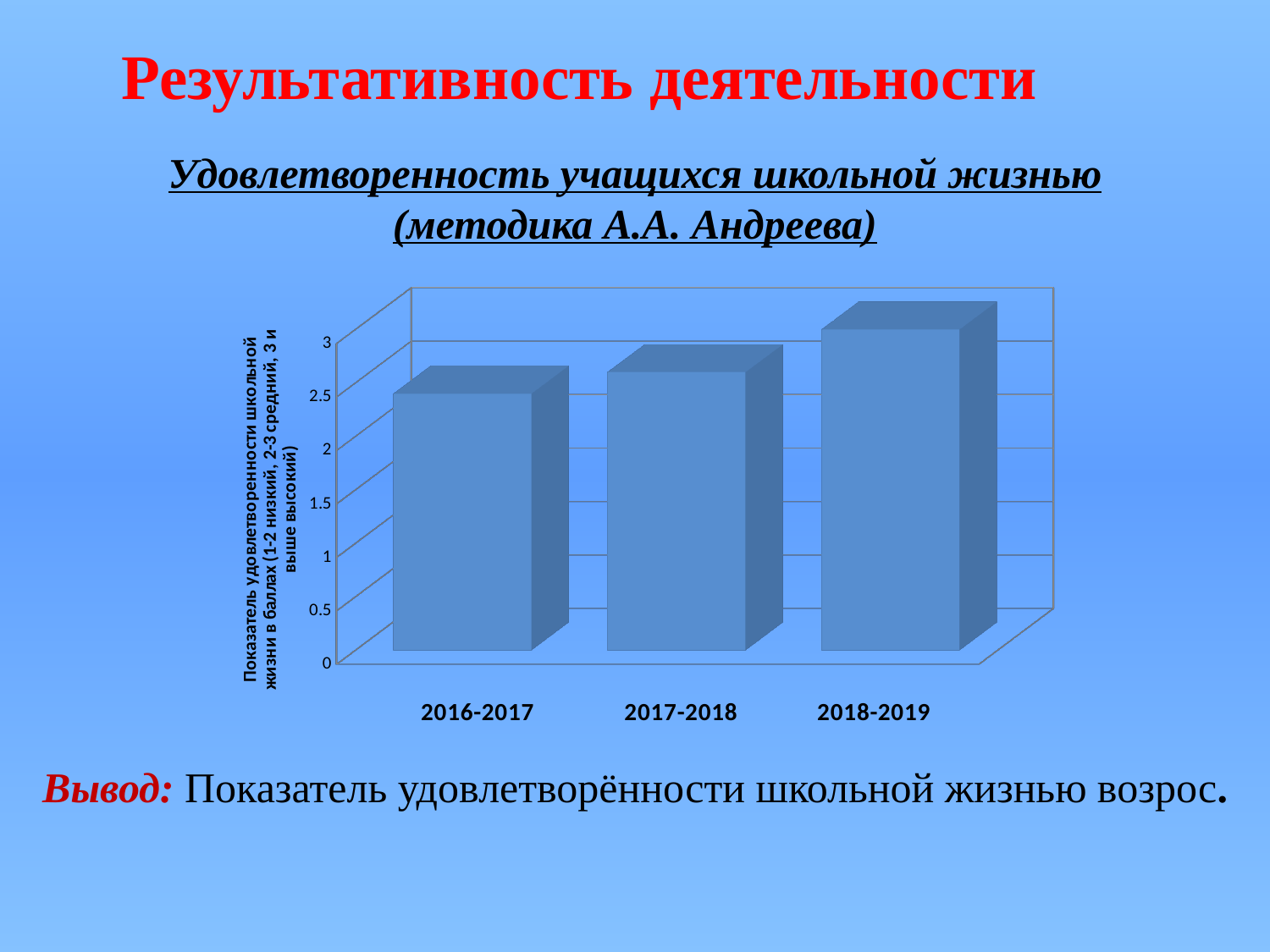
Is the value for 2016-2017 greater or less than 2? greater Which is larger in the chart: the value for 2017-2018 or the value for 2016-2017? 2017-2018 Which school year has the lowest satisfaction indicator in the chart? 2016-2017 Is the value for 2016-2017 greater or less than 3? less Is the value for 2018-2019 greater or less than 2.5? greater Which is larger in the chart: the value for 2018-2019 or the value for 2016-2017? 2018-2019 What kind of chart is shown on the slide? bar chart Do the values in the chart rise or fall from 2016-2017 to 2018-2019? rise What is the highest tick value shown on the vertical axis of the chart? 3 Which school year has the highest satisfaction indicator in the chart? 2018-2019 How many school years (categories) are shown on the x axis of the chart? 3